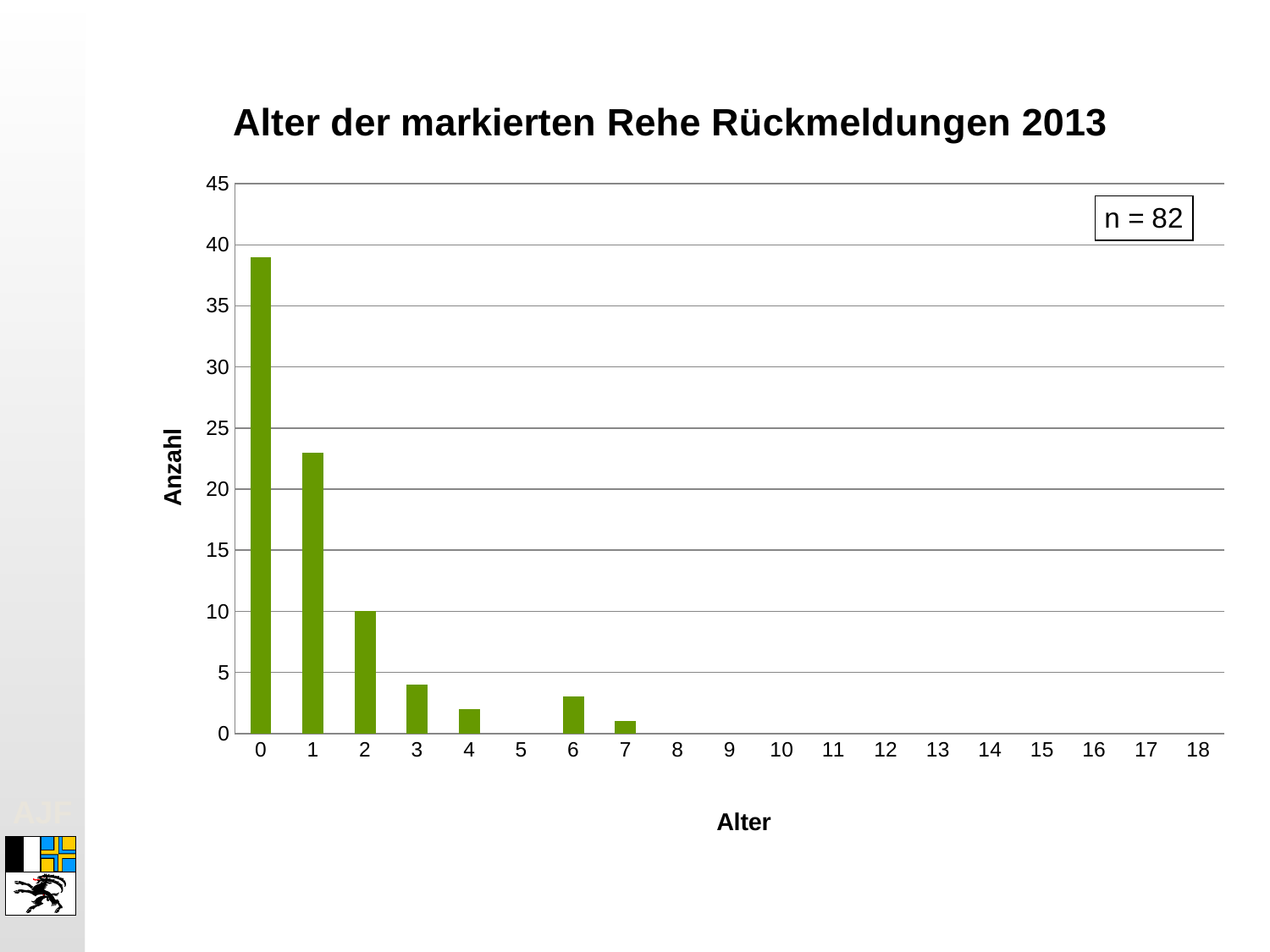
What kind of chart is shown on the slide? bar chart Do the Anzahl values rise or fall from Alter 0 to Alter 4? fall Is the Anzahl for Alter 1 greater or less than 20? greater Which has a larger Anzahl, Alter 6 or Alter 7? Alter 6 Is the Anzahl for Alter 3 greater or less than 5? less Is the Anzahl for Alter 0 greater or less than 35? greater How many age categories are shown on the x axis? 19 What is the title of the chart? Alter der markierten Rehe Rückmeldungen 2013 Which has a larger Anzahl, Alter 1 or Alter 3? Alter 1 What is the Anzahl for Alter 2? 10 Which age (Alter) has the highest Anzahl? 0